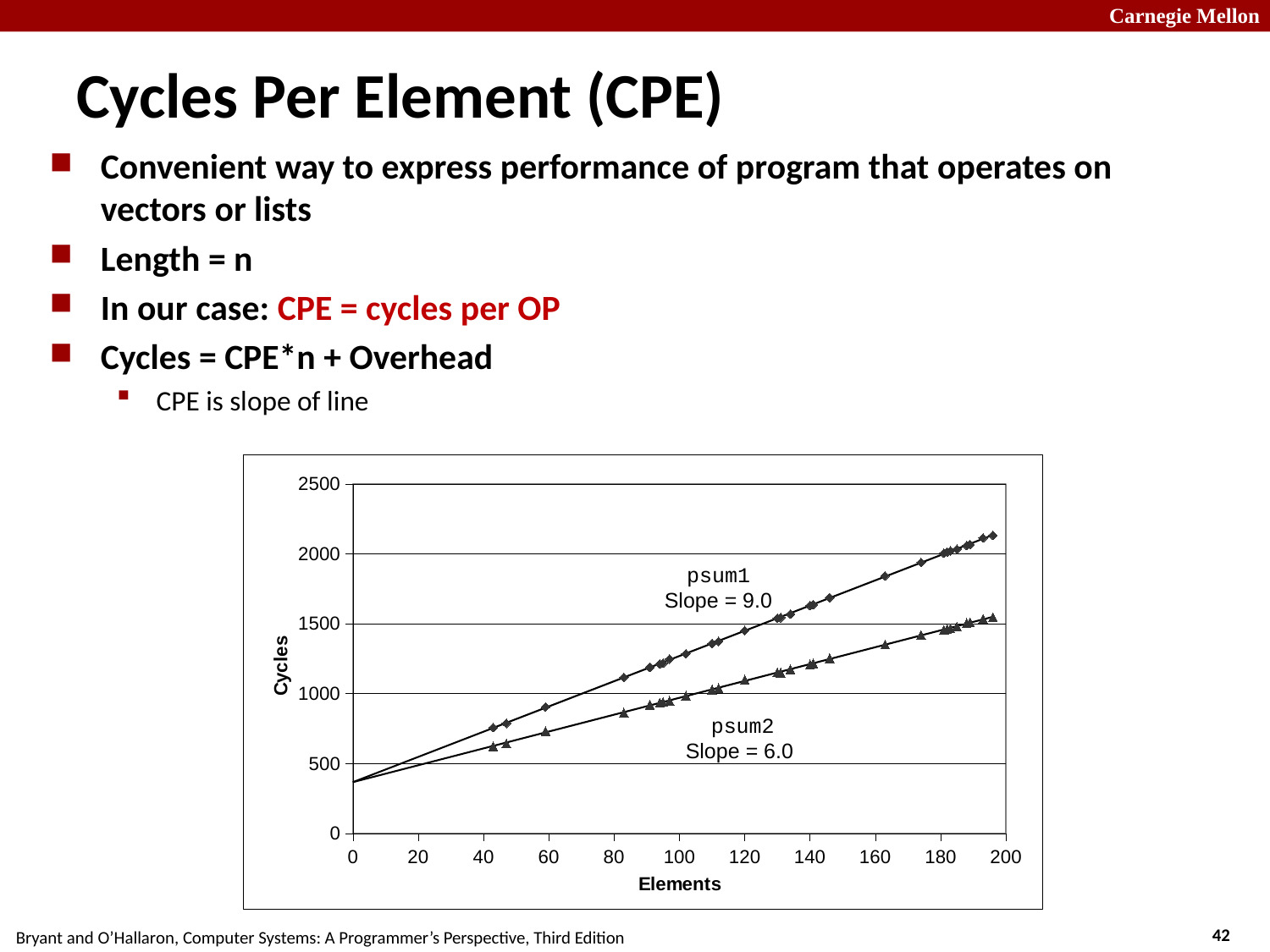
How many data series are plotted in the chart? 2 Do the Cycles values rise or fall as Elements increases? rise Which series has the steeper slope, psum1 or psum2? psum1 Is the psum1 value at about 60 elements greater or less than 1000 cycles? less What is the label of the vertical axis? Cycles Is the psum1 value at about 195 elements greater or less than 2000 cycles? greater Is the psum2 value at about 45 elements greater or less than 500 cycles? greater What is the slope of the psum1 line? 9.0 What is the slope of the psum2 line? 6.0 What kind of chart is shown on the slide? scatter chart What is the label of the horizontal axis? Elements